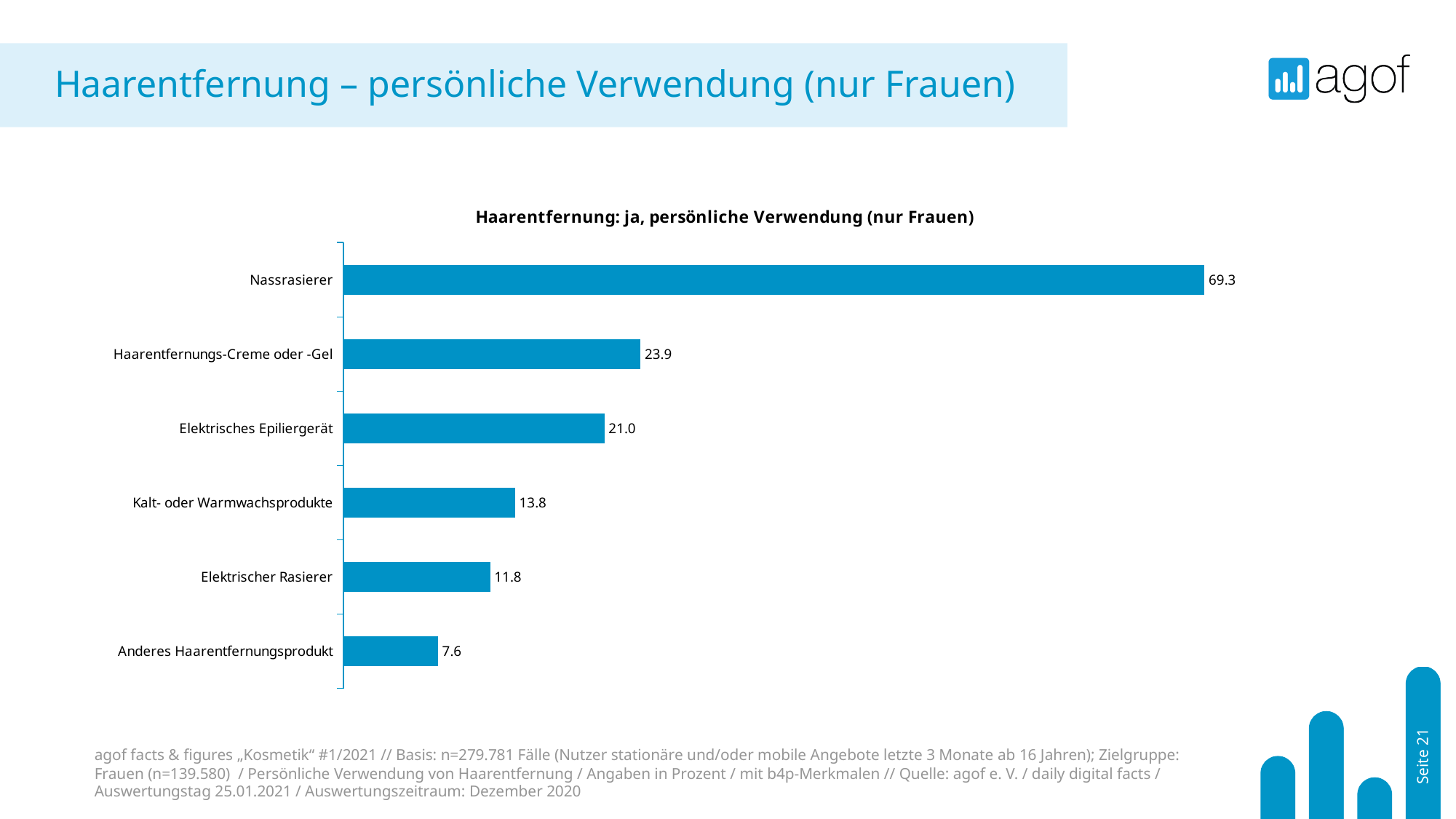
What is the difference between the values for Kalt- oder Warmwachsprodukte and Elektrischer Rasierer? 2.0 What is the title of the chart? Haarentfernung: ja, persönliche Verwendung (nur Frauen) Which category has the highest value? Nassrasierer What is the value for Haarentfernungs-Creme oder -Gel? 23.9 What is the value for Anderes Haarentfernungsprodukt? 7.6 Which category has the lowest value? Anderes Haarentfernungsprodukt What is the difference between the values for Nassrasierer and Haarentfernungs-Creme oder -Gel? 45.4 What is the value for Nassrasierer? 69.3 How many categories are shown in the chart? 6 What kind of chart is shown on the slide? Bar chart Which is larger, the value for Elektrisches Epiliergerät or the value for Kalt- oder Warmwachsprodukte? Elektrisches Epiliergerät What is the value for Elektrisches Epiliergerät? 21.0